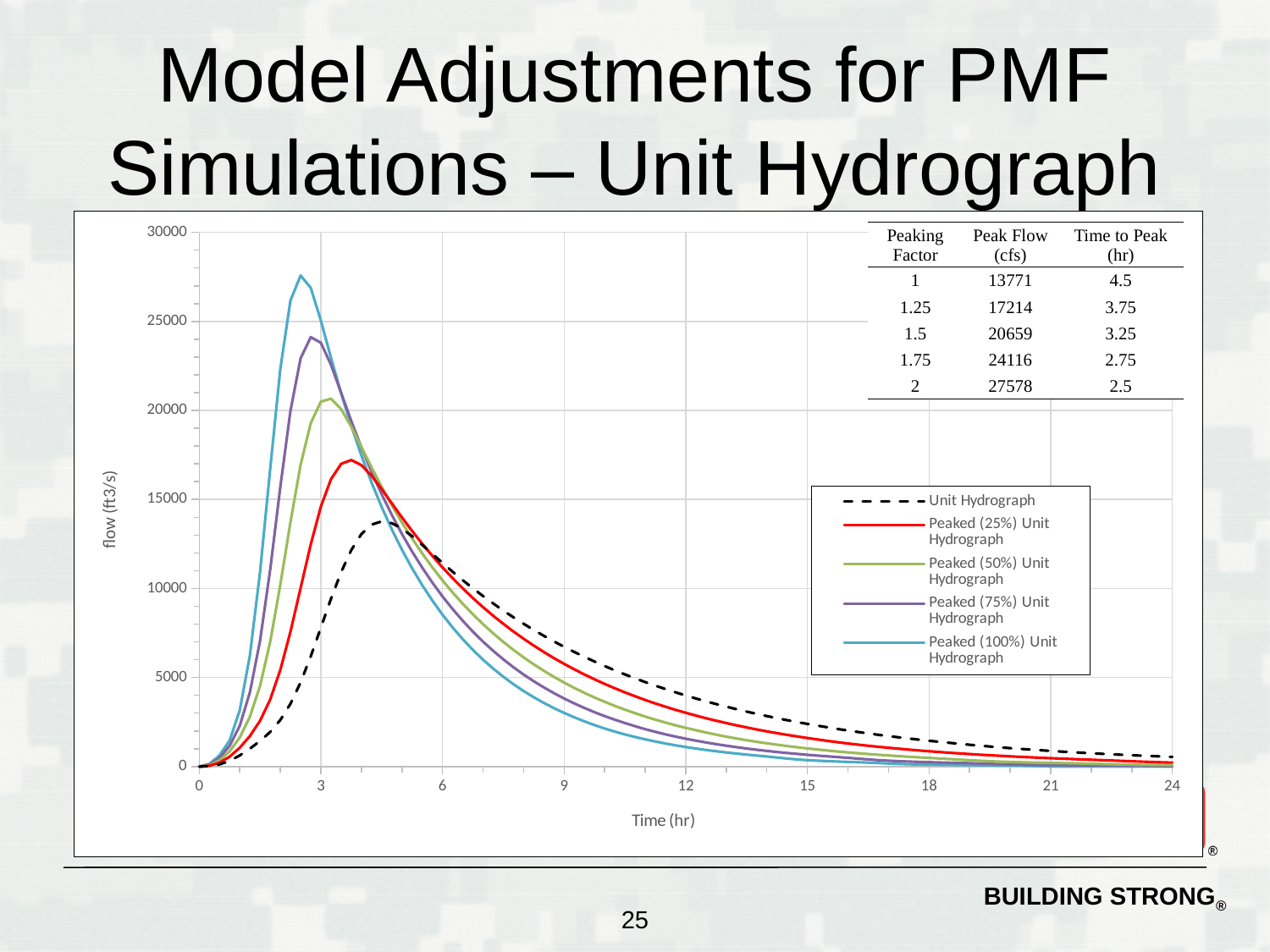
What is the label on the vertical axis of the chart? flow (ft3/s) At 12 hours, which is larger: the Unit Hydrograph or the Peaked (100%) Unit Hydrograph? Unit Hydrograph Is the peak value of the Unit Hydrograph (dashed line) greater or less than 15000? less How many series does the chart legend list? 5 According to the table on the slide, what is the peak flow (cfs) for a peaking factor of 2? 27578 According to the table on the slide, what is the time to peak (hr) for a peaking factor of 1? 4.5 Which series reaches the highest peak flow on the chart? Peaked (100%) Unit Hydrograph What is the label on the horizontal axis of the chart? Time (hr) Is the peak value of the Peaked (100%) Unit Hydrograph greater or less than 25000? greater Which series has the lowest peak flow on the chart? Unit Hydrograph Using the table on the slide, what is the difference in peak flow (cfs) between peaking factor 2 and peaking factor 1? 13807 What kind of chart is shown on the slide? line chart